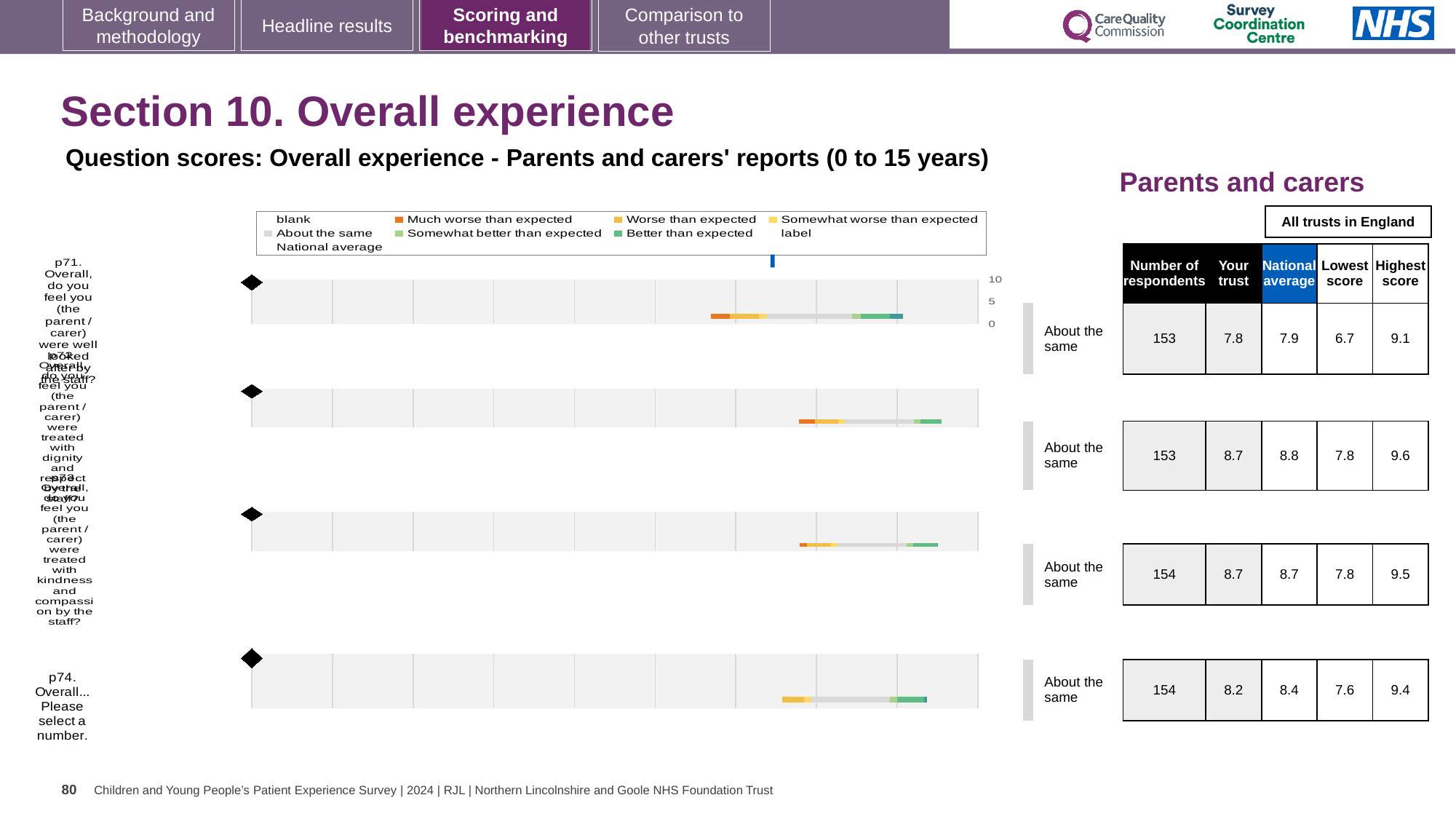
What is the highest score among all trusts in England for question p74? 9.4 Which question row has the highest 'Highest score' value across all trusts in England? The second row (9.6) What is the difference between the highest score (9.1) and the lowest score (6.7) for question p71? 2.4 What benchmark category is shown next to the chart for question p71? About the same What is the 'Your trust' score for question p71 (Overall, do you feel you were well looked after by the staff?)? 7.8 What is the national average score for question p71? 7.9 Which is larger for question p71: the 'Your trust' score or the national average? National average Which question row has the lowest 'Your trust' score? p71 What kind of chart is used to show the question scores on this slide? bar chart Is the 'Your trust' score for question p74 greater or less than 5 on the chart axis? greater How many respondents answered question p74 (Overall... Please select a number)? 154 How many question rows (bars) are plotted in the chart? 4